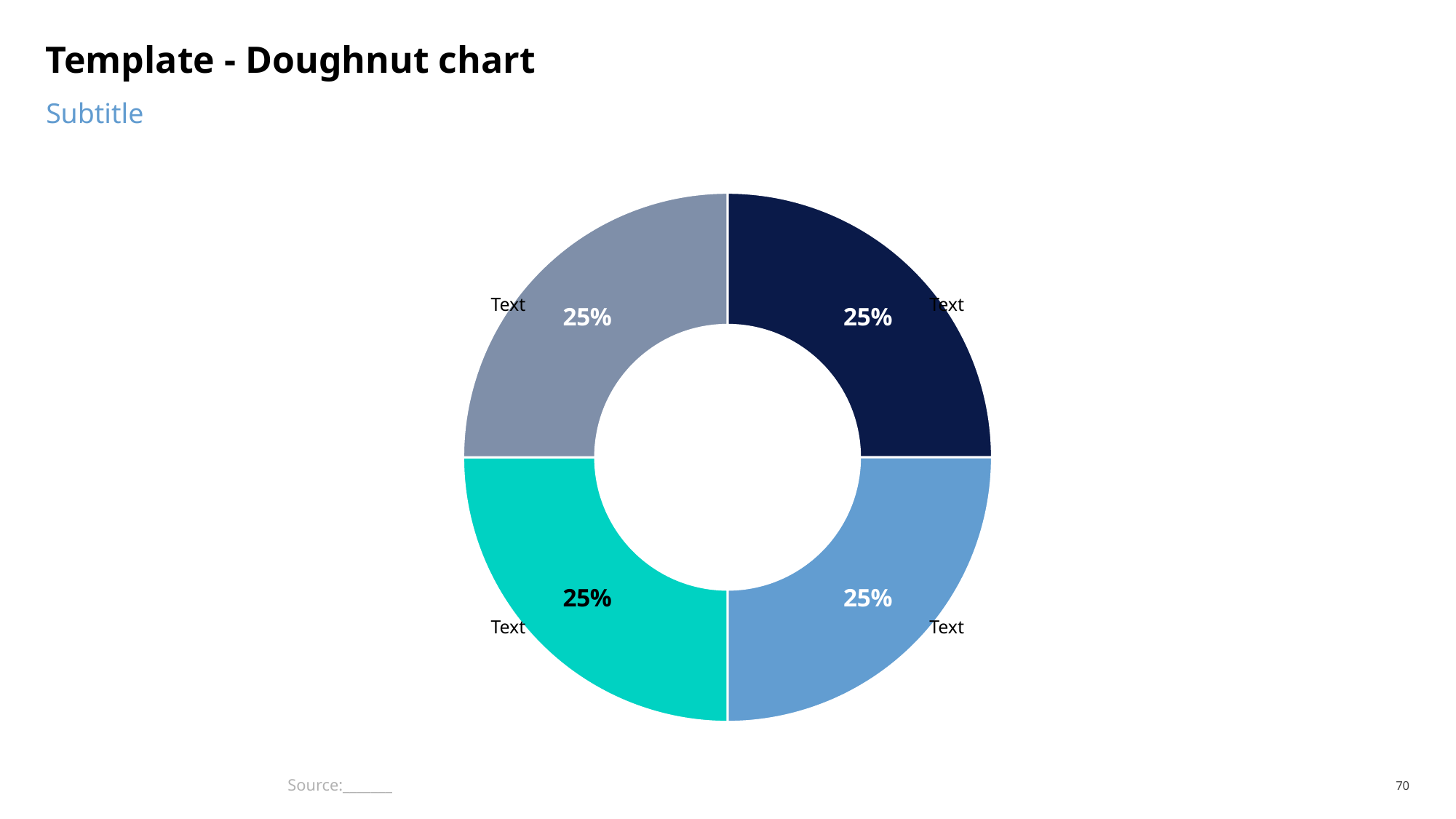
What is the combined share of the dark navy slice and the light blue slice? 50% What share of the doughnut does the teal slice in the bottom left represent? 25% What share of the doughnut does the light blue slice in the bottom right represent? 25% Do all four slices of the doughnut chart have the same value? Yes, each is 25% How many slices does the doughnut chart have? 4 What label is shown next to each slice of the doughnut chart? Text What share of the doughnut does the dark navy slice in the top right represent? 25% What is the title of the slide containing the doughnut chart? Template - Doughnut chart What is the difference between the teal slice's share and the grey slice's share? 0% What kind of chart is shown on the slide? Doughnut chart